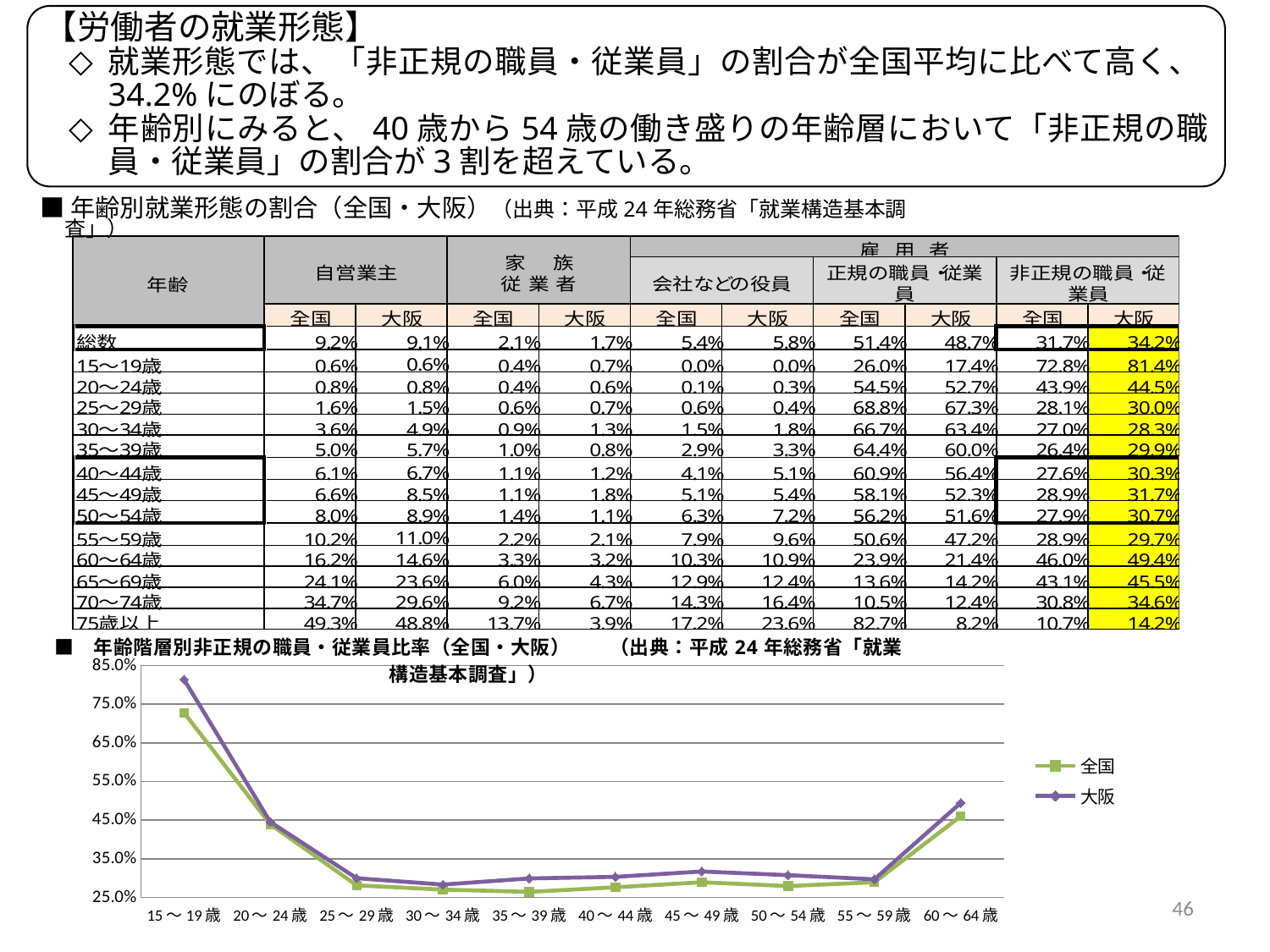
In the line chart, which age category has the highest value for 全国? 15〜19歳 In the line chart, is the value for 大阪 at 60〜64歳 greater or less than 45.0%? greater What kind of chart is shown at the bottom of the slide (年齢階層別非正規の職員・従業員比率)? line chart In the line chart, which colour is used for the 大阪 series? purple In the line chart, do the values for 全国 rise or fall from 15〜19歳 to 25〜29歳? fall In the line chart, which series has the higher value at 15〜19歳, 全国 or 大阪? 大阪 How many age categories are plotted along the x axis of the line chart? 10 In the line chart, is the value for 大阪 at 15〜19歳 greater or less than 75.0%? greater How many series does the legend of the line chart list? 2 In the line chart, is the value for 全国 at 35〜39歳 greater or less than 35.0%? less What are the two series named in the legend of the line chart? 全国 and 大阪 In the line chart, which age category has the highest value for 大阪? 15〜19歳